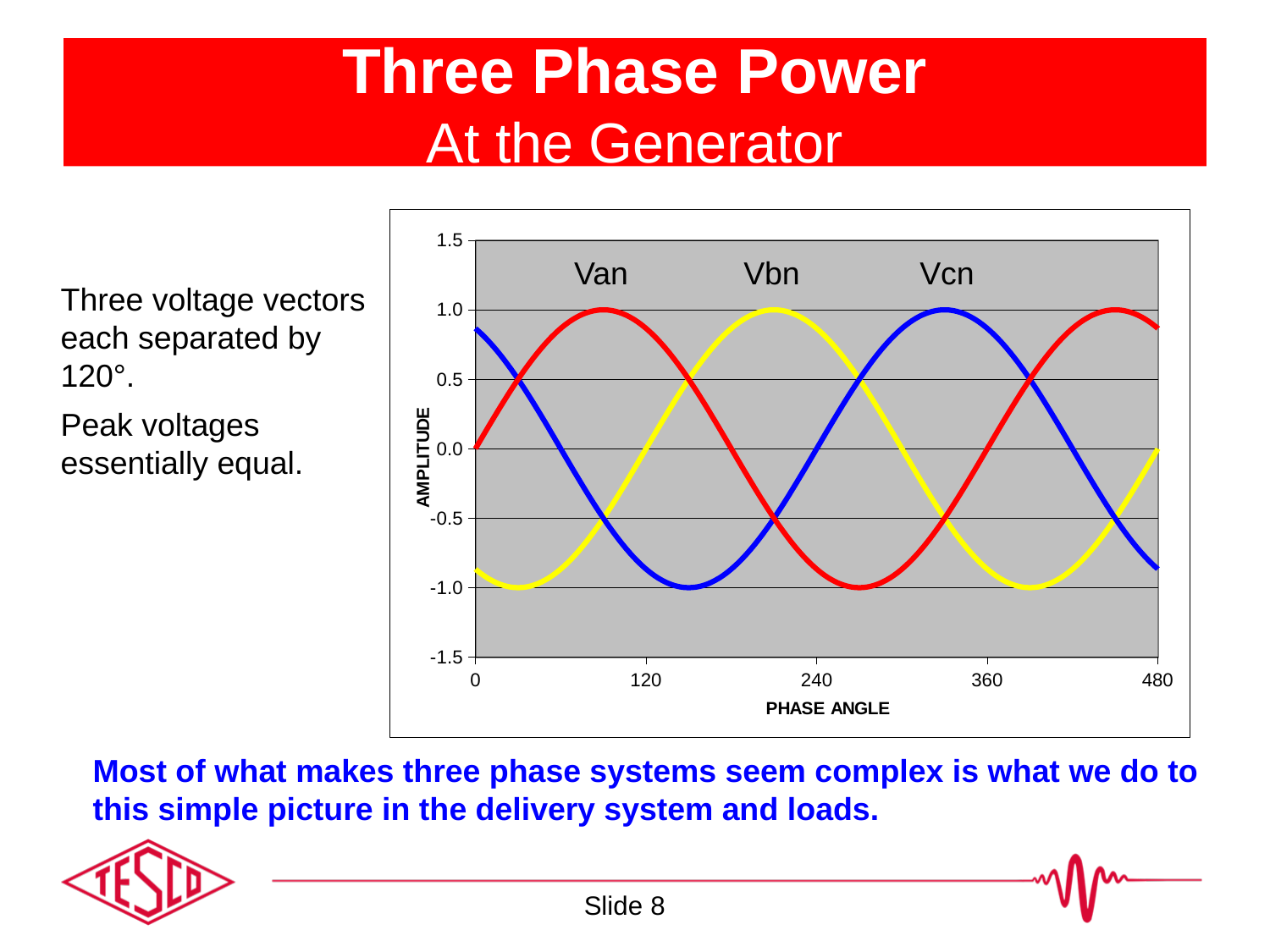
What is the lowest amplitude reached by the Vbn line? -1.0 Does the Vbn line rise or fall between phase angles 0 and 120? rise What kind of chart is shown on the slide? line chart Is the amplitude of Vcn at a phase angle of 120 greater or less than -0.5? less Is the amplitude of Vcn at a phase angle of 0 greater or less than 0.5? greater Is the amplitude of Vbn at a phase angle of 0 greater or less than -0.5? less How many series are plotted on the chart? 3 What colour is the Van line on the chart? red What is the label of the x axis of the chart? PHASE ANGLE What is the peak amplitude reached by the Van line? 1.0 What is the amplitude of Van at a phase angle of 0? 0.0 At a phase angle of 0, which series has the highest amplitude? Vcn